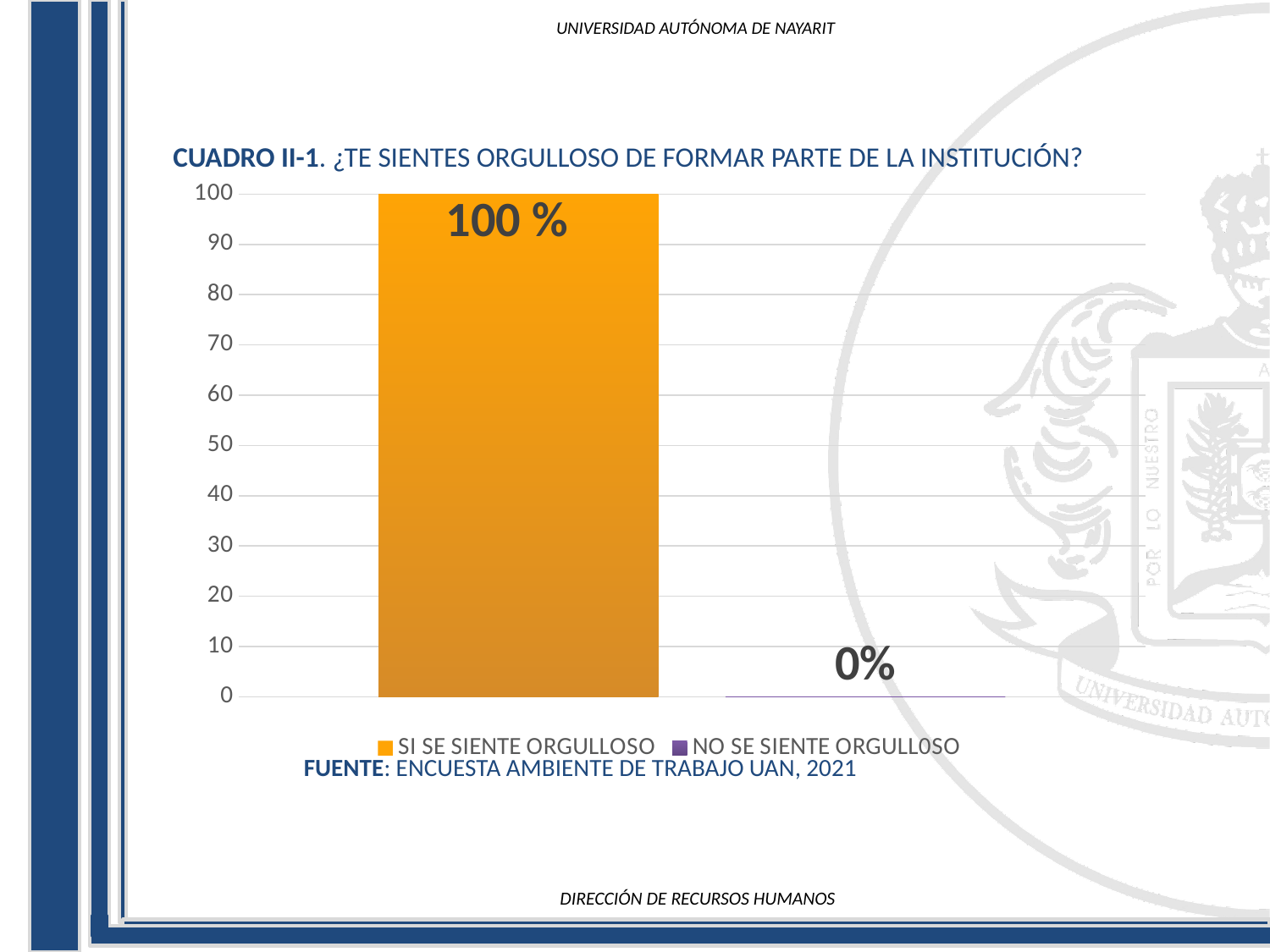
What is the title of the chart? CUADRO II-1. ¿TE SIENTES ORGULLOSO DE FORMAR PARTE DE LA INSTITUCIÓN? What value is shown for NO SE SIENTE ORGULL0SO? 0% What kind of chart is shown on the slide? bar chart What is the maximum value shown on the vertical axis? 100 What is the difference between the values for SI SE SIENTE ORGULLOSO and NO SE SIENTE ORGULL0SO? 100 % What colour is the bar for SI SE SIENTE ORGULLOSO? orange What value is shown for SI SE SIENTE ORGULLOSO? 100 % Which is larger, the value for SI SE SIENTE ORGULLOSO or for NO SE SIENTE ORGULL0SO? SI SE SIENTE ORGULLOSO Which series has the lowest value? NO SE SIENTE ORGULL0SO Which series has the highest value? SI SE SIENTE ORGULLOSO Is the value for SI SE SIENTE ORGULLOSO greater or less than 50? greater How many series does the legend list? 2